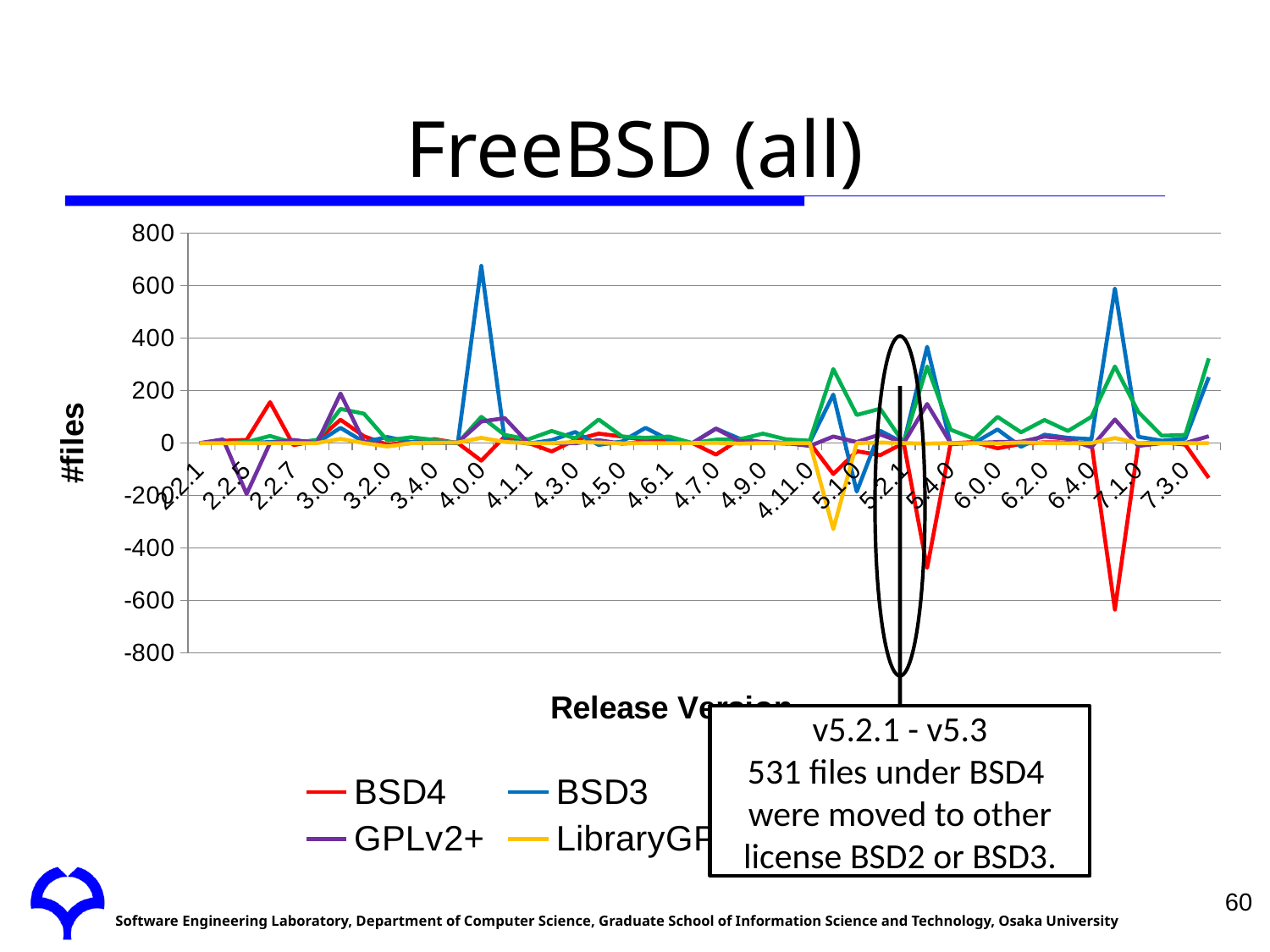
Is the value for LibraryGPL at release 5.1.0 greater or less than -200? greater Is the value for GPLv2+ at release 3.0.0 greater or less than 100? greater What is the label of the vertical axis? #files Which series reaches the highest value anywhere on the chart? BSD3 What is the title of the chart? FreeBSD (all) Is the value for BSD4 at release 7.1.0 greater or less than -400? greater What kind of chart is shown on the slide? line chart Which series reaches the lowest value anywhere on the chart? BSD4 At which release version does BSD3 reach its highest value? 4.0.0